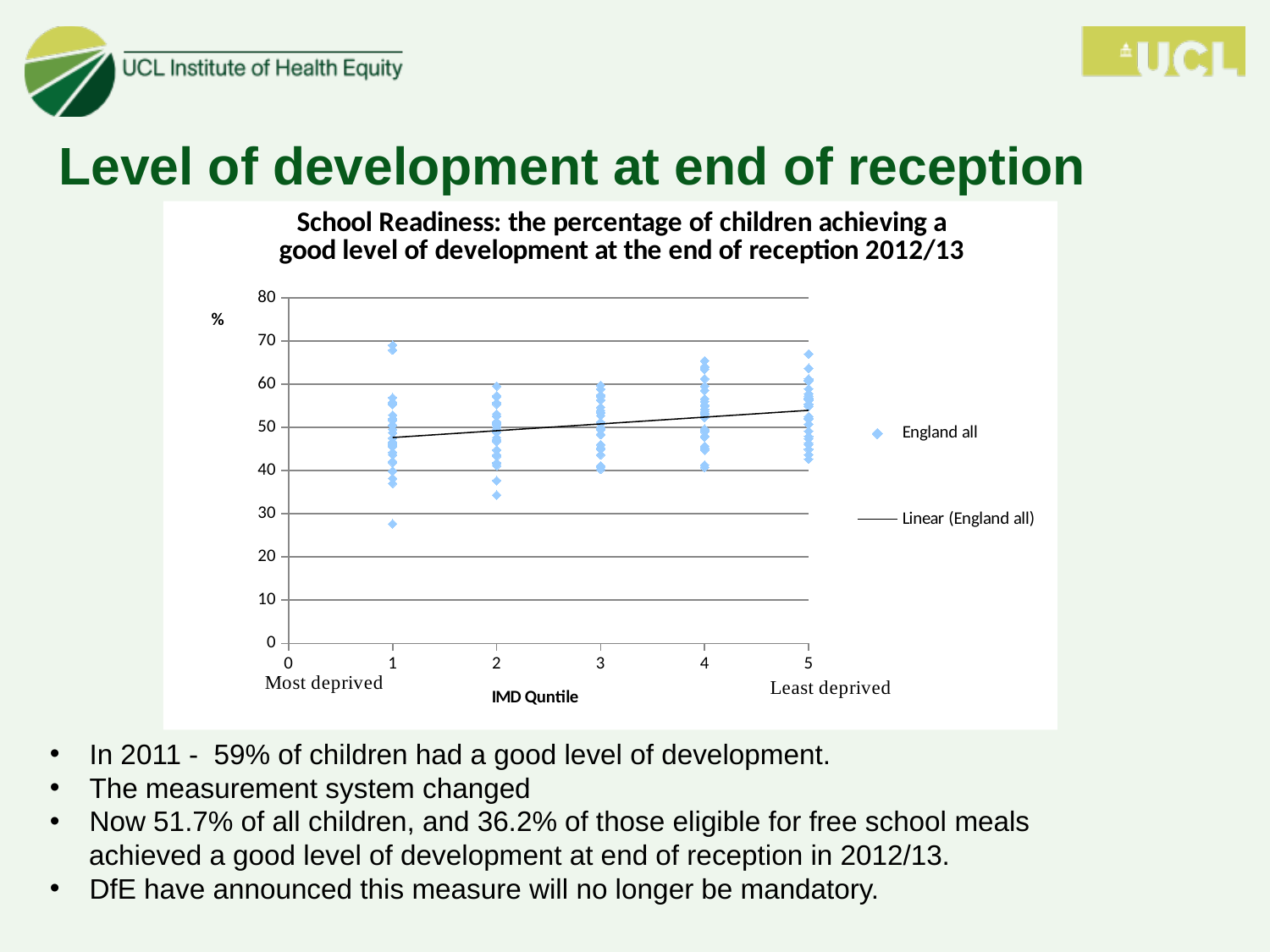
Is the lowest plotted value for IMD quintile 1 greater or less than 30? less What kind of chart is shown on the slide? Scatter chart Is the highest plotted value for IMD quintile 5 greater or less than 60? greater Is the highest plotted value for IMD quintile 4 greater or less than 60? greater Which IMD quintile contains the lowest plotted point on the chart? 1 What are the two entries in the chart legend? England all; Linear (England all) What is the label of the x axis of the chart? IMD Quntile How many entries does the chart legend list? 2 Does the linear trend line rise or fall from IMD quintile 1 to quintile 5? Rise How many IMD quintiles are plotted along the x axis? 5